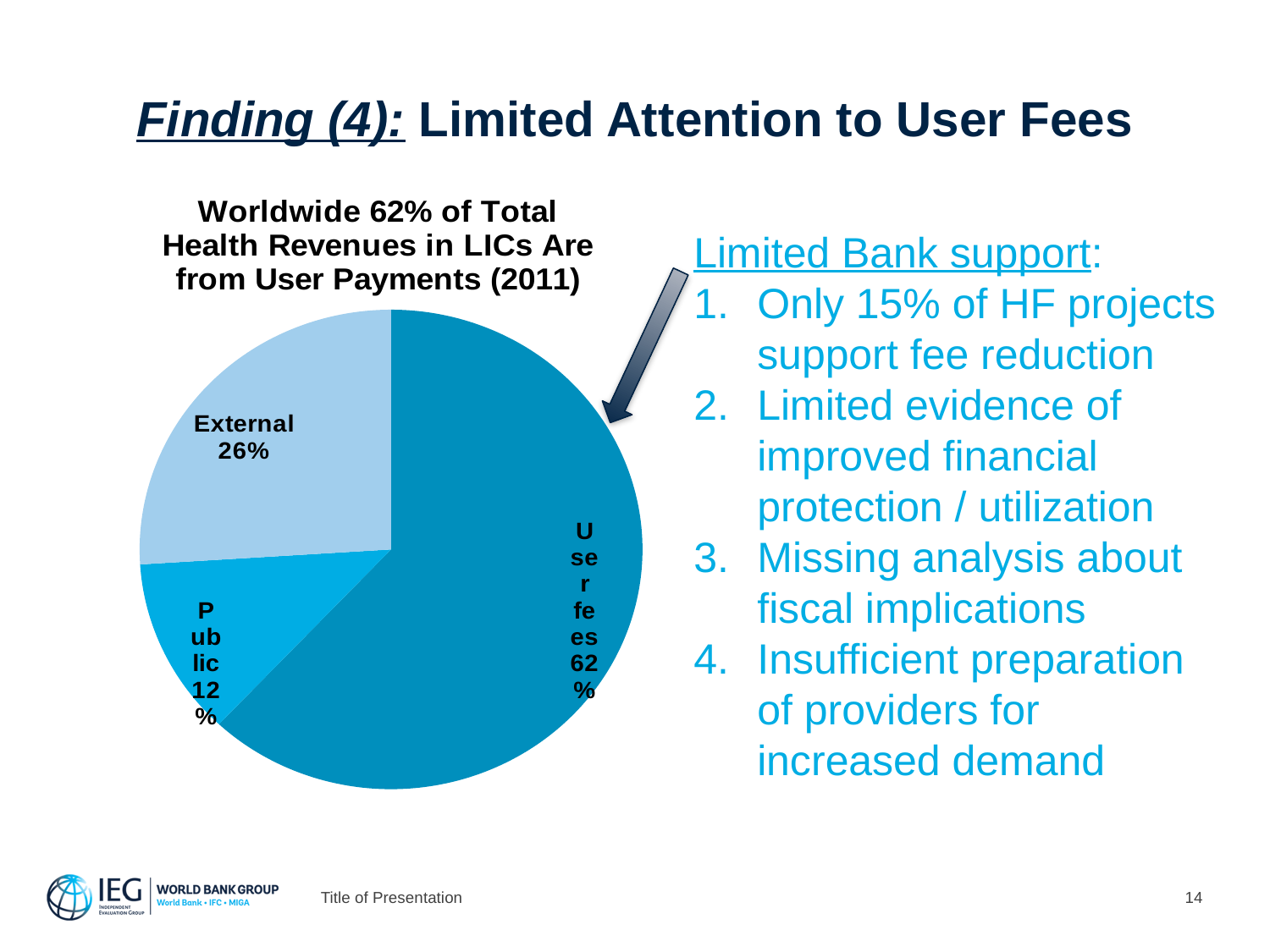
What share of total health revenues comes from user fees? 62% What is the difference in percentage points between the user fees share and the external share? 36 percentage points What is the difference in percentage points between the external share and the public share? 14 percentage points Which revenue source has the smallest share of the pie? Public What share of total health revenues comes from external sources? 26% What share of total health revenues comes from public sources? 12% What type of chart is shown on the slide? Pie chart How many slices does the pie chart have? 3 What is the title of the pie chart? Worldwide 62% of Total Health Revenues in LICs Are from User Payments (2011) What year does the pie chart's data refer to? 2011 Which is larger, the external share or the public share? External Which revenue source has the largest share of the pie? User fees